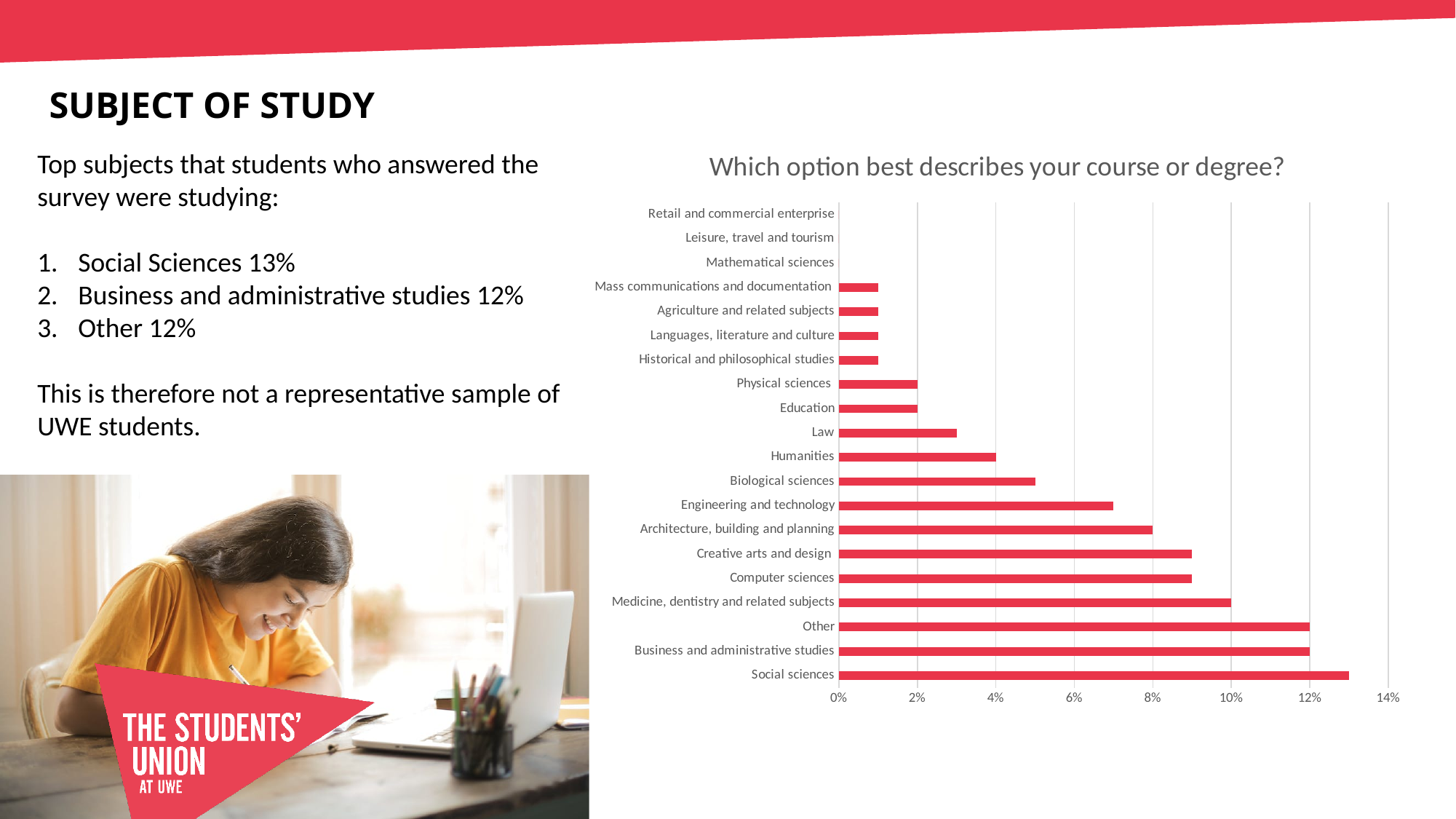
Is the value for Creative arts and design greater or less than 10%? less What kind of chart is shown on the slide? bar chart Which is larger, the value for Humanities or the value for Law? Humanities What is the difference between the values for Social sciences and Business and administrative studies? 1% Is the value for Engineering and technology greater or less than 6%? greater What is the value for Social sciences? 13% What is the value for Business and administrative studies? 12% What is the value for Medicine, dentistry and related subjects? 10% What is the title of the chart? Which option best describes your course or degree? What is the value for Education? 2% Which category has the highest value in the chart? Social sciences How many categories are listed on the chart's vertical axis? 20